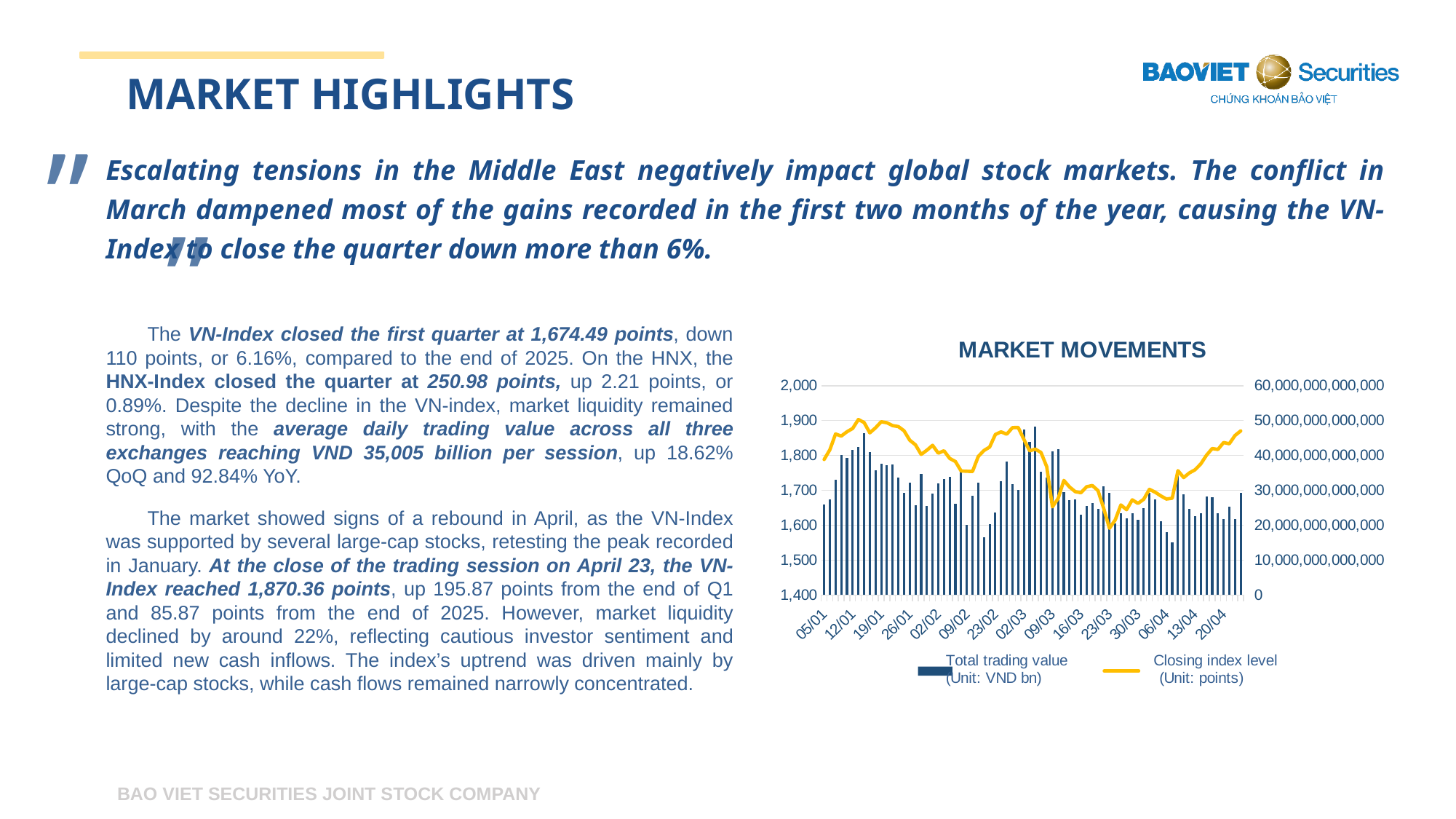
In the MARKET MOVEMENTS chart, is the closing index level at 23/03 greater or less than 1,700? less In the MARKET MOVEMENTS chart, is the closing index level higher at 19/01 or at 23/03? 19/01 What is the title of the chart on the slide? MARKET MOVEMENTS In the MARKET MOVEMENTS chart, is the closing index level at 02/03 greater or less than 1,800? greater In the MARKET MOVEMENTS chart, does the closing index level rise or fall between 02/03 and 23/03? fall How many series does the legend of the MARKET MOVEMENTS chart list? 2 In the MARKET MOVEMENTS chart, is the closing index level at 20/04 greater or less than 1,800? greater In the MARKET MOVEMENTS chart, does the closing index level rise or fall between 23/03 and 20/04? rise What kind of chart is the MARKET MOVEMENTS chart? Combined bar and line chart In the MARKET MOVEMENTS chart, which series is shown as a line? Closing index level (Unit: points)